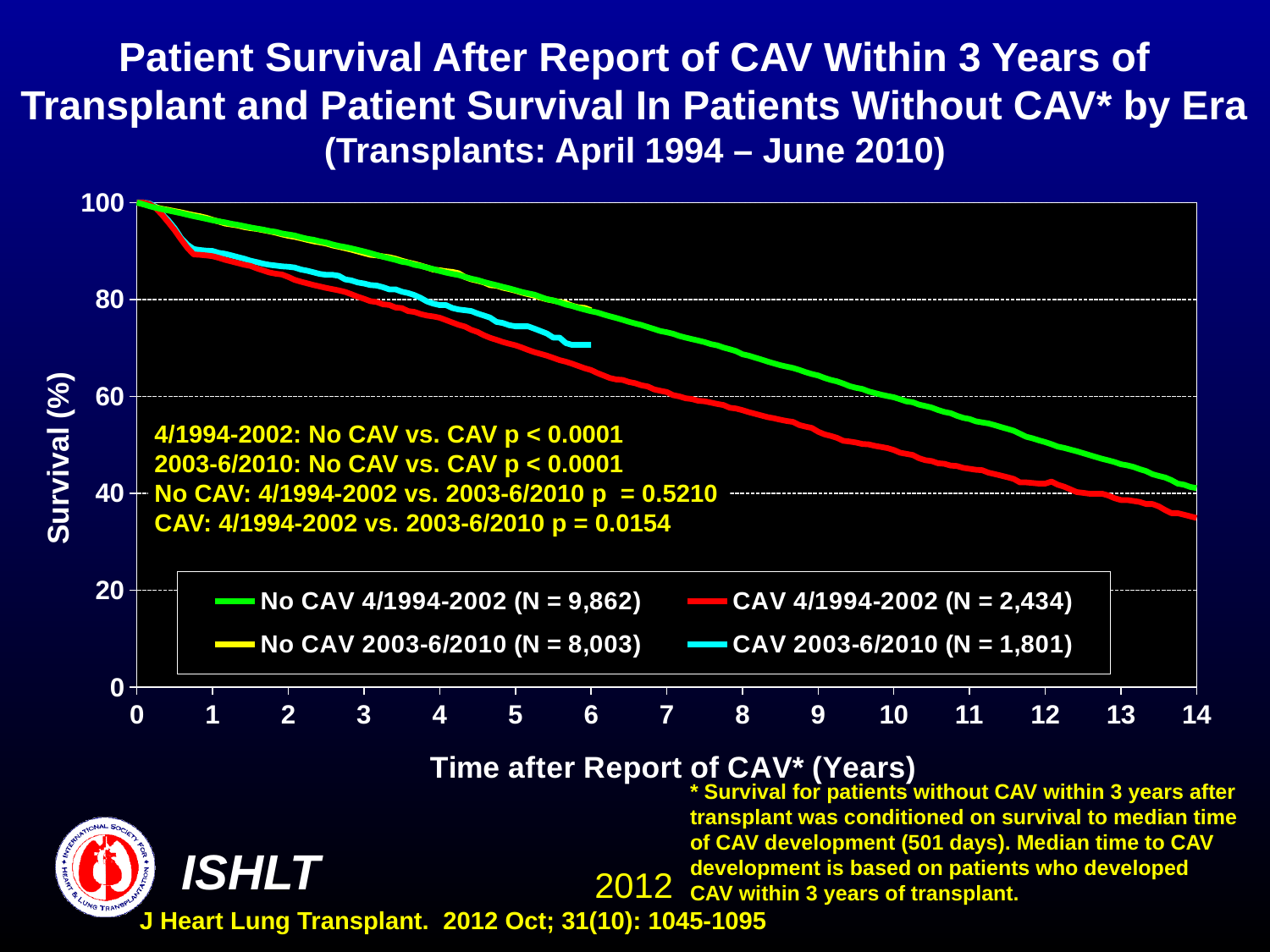
Is the survival value for No CAV 4/1994-2002 at 5 years greater or less than 80? greater What is the label of the y axis? Survival (%) Is the survival value for CAV 4/1994-2002 at 1 year greater or less than 80? greater Is the survival value for CAV 4/1994-2002 at 14 years greater or less than 40? less What is the maximum value shown on the x axis (Time after Report of CAV, Years)? 14 What kind of chart is shown on the slide? line chart Which series has the lowest survival at 14 years? CAV 4/1994-2002 Do the survival curves rise or fall as time after report of CAV increases? fall How many series does the legend list? 4 At 10 years, which series has the higher survival: No CAV 4/1994-2002 or CAV 4/1994-2002? No CAV 4/1994-2002